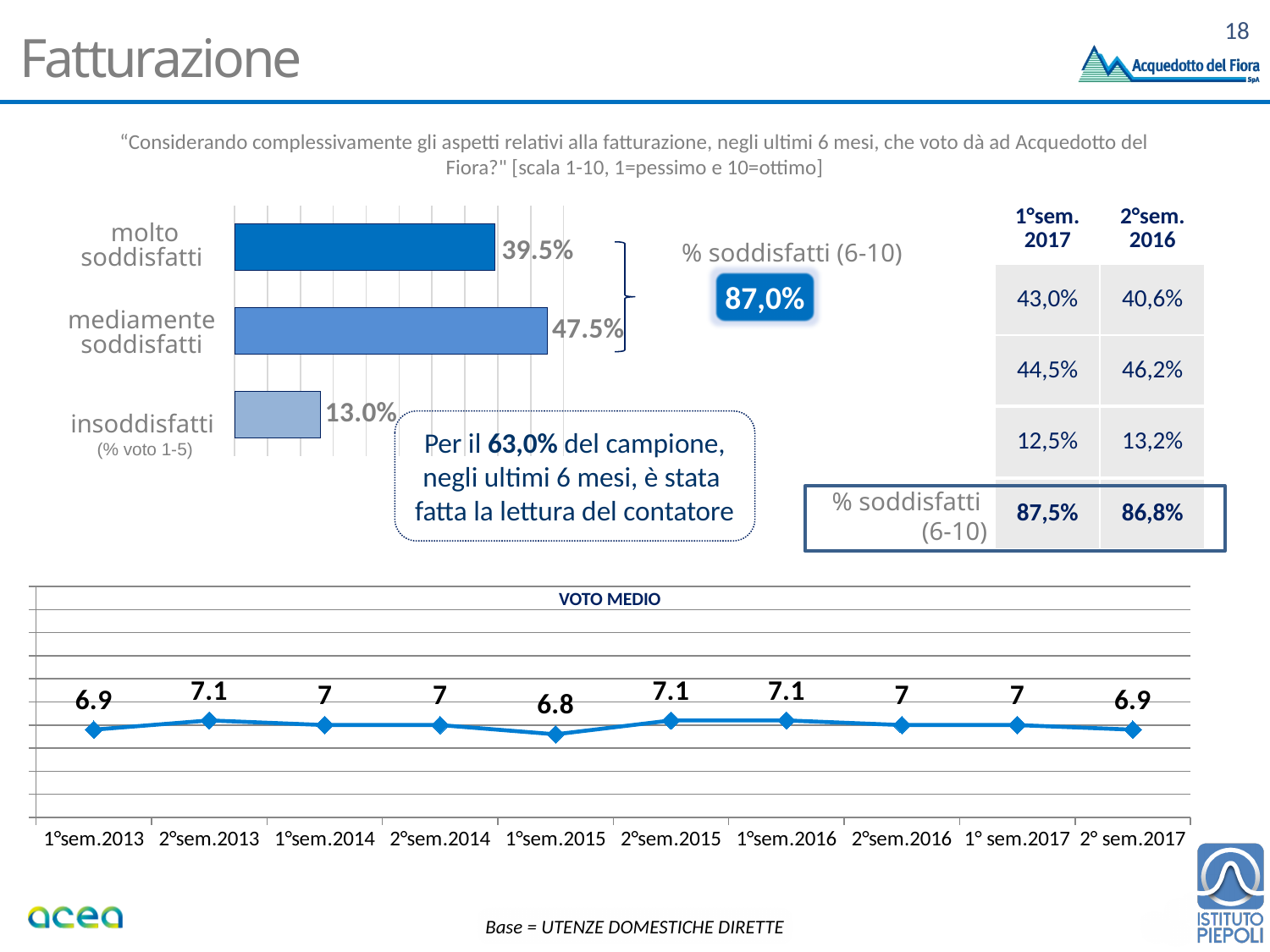
In the "VOTO MEDIO" chart, which period has the lowest value? 1°sem.2015 What kind of chart is the chart at the top of the slide? bar chart In the bar chart at the top of the slide, what is the value for "insoddisfatti"? 13.0% In the bar chart at the top of the slide, what is the value for "mediamente soddisfatti"? 47.5% What kind of chart is the "VOTO MEDIO" chart? line chart In the bar chart at the top of the slide, how many categories are shown? 3 In the bar chart at the top of the slide, which category has the highest value? mediamente soddisfatti In the bar chart at the top of the slide, what is the difference between "mediamente soddisfatti" and "molto soddisfatti"? 8.0% In the bar chart at the top of the slide, which category has the lowest value? insoddisfatti In the "VOTO MEDIO" chart, what is the value for 2° sem.2017? 6.9 In the "VOTO MEDIO" chart, how many data points are plotted? 10 In the "VOTO MEDIO" chart, what is the value for 1°sem.2015? 6.8